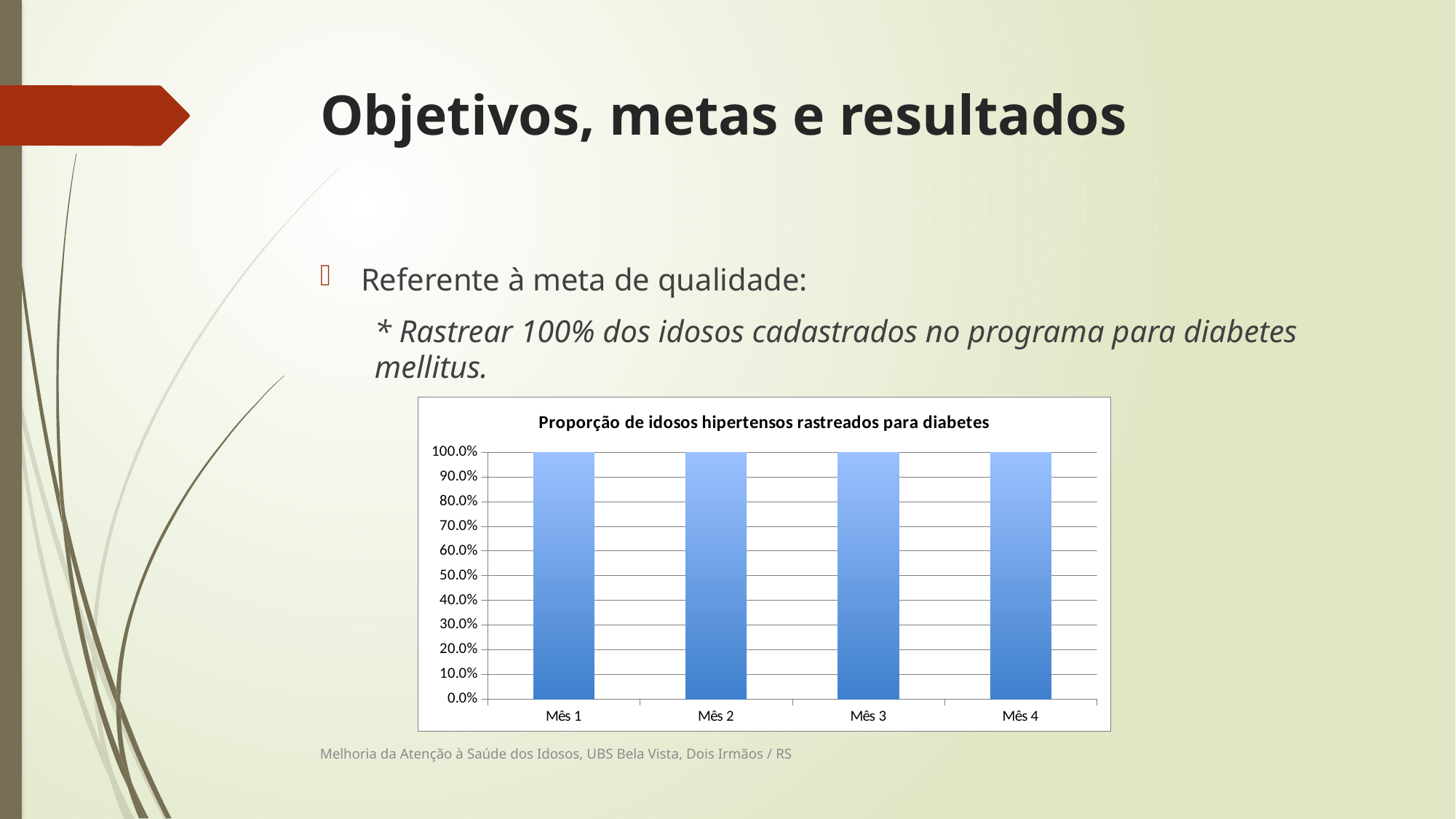
Is the value for Mês 3 greater or less than 90.0%? greater What is the title of the chart? Proporção de idosos hipertensos rastreados para diabetes What is the label of the first category on the x axis? Mês 1 What type of chart is shown on the slide? bar chart How many months (categories) are plotted in the chart? 4 Is the value for Mês 1 greater or less than 50.0%? greater